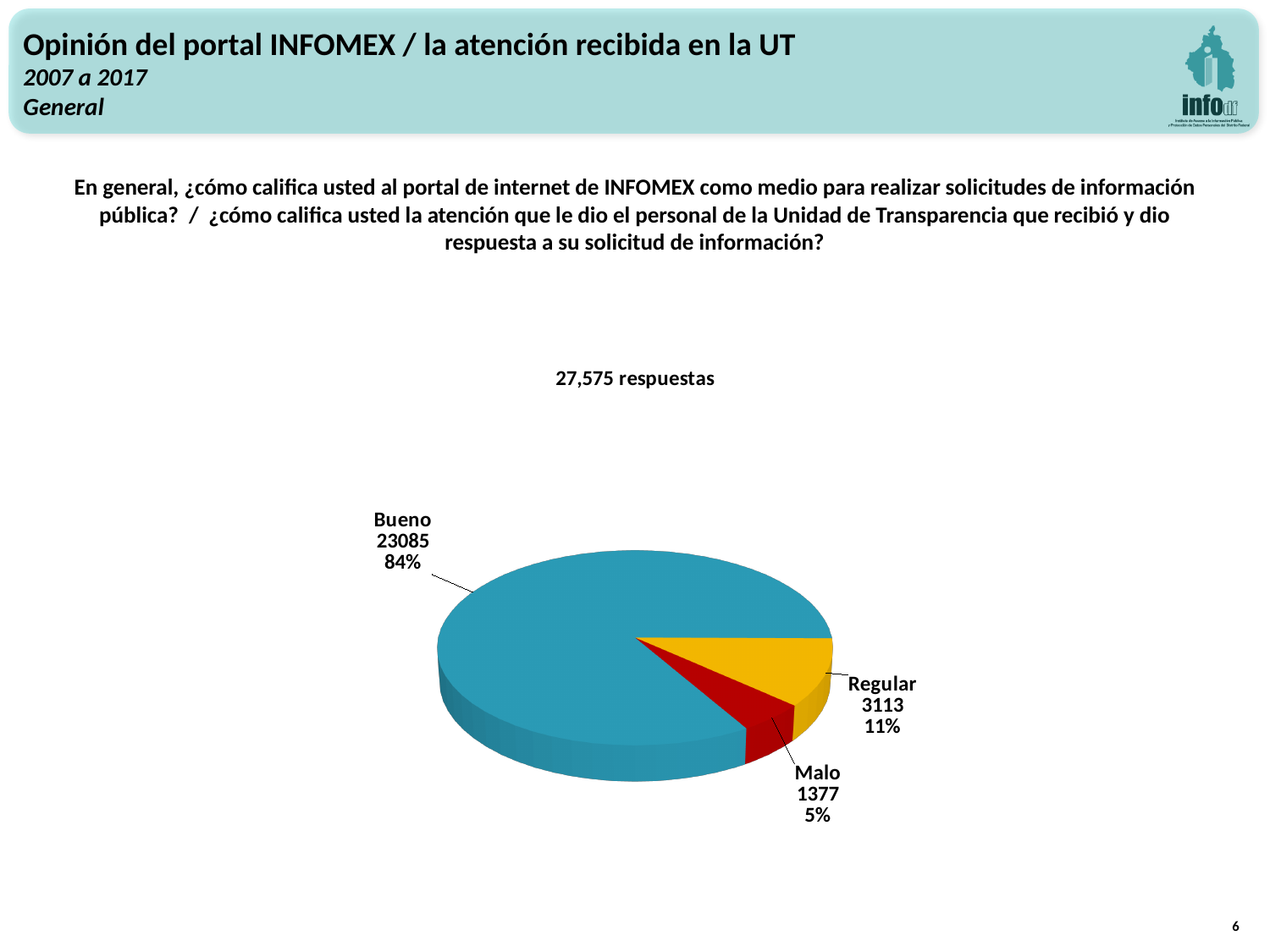
What is the value for Malo? 1377 What is the value for Regular? 3113 What is the difference between the values for Regular and Malo? 1736 What share of the pie does Malo represent? 5% What is the total number of responses shown above the chart? 27,575 respuestas How many slices does the pie chart have? 3 What kind of chart is shown on the slide? pie chart Which is larger, the value for Regular or the value for Malo? Regular Which category has the smallest slice? Malo Which category has the largest slice? Bueno What is the value for Bueno? 23085 What share of the pie does Bueno represent? 84%